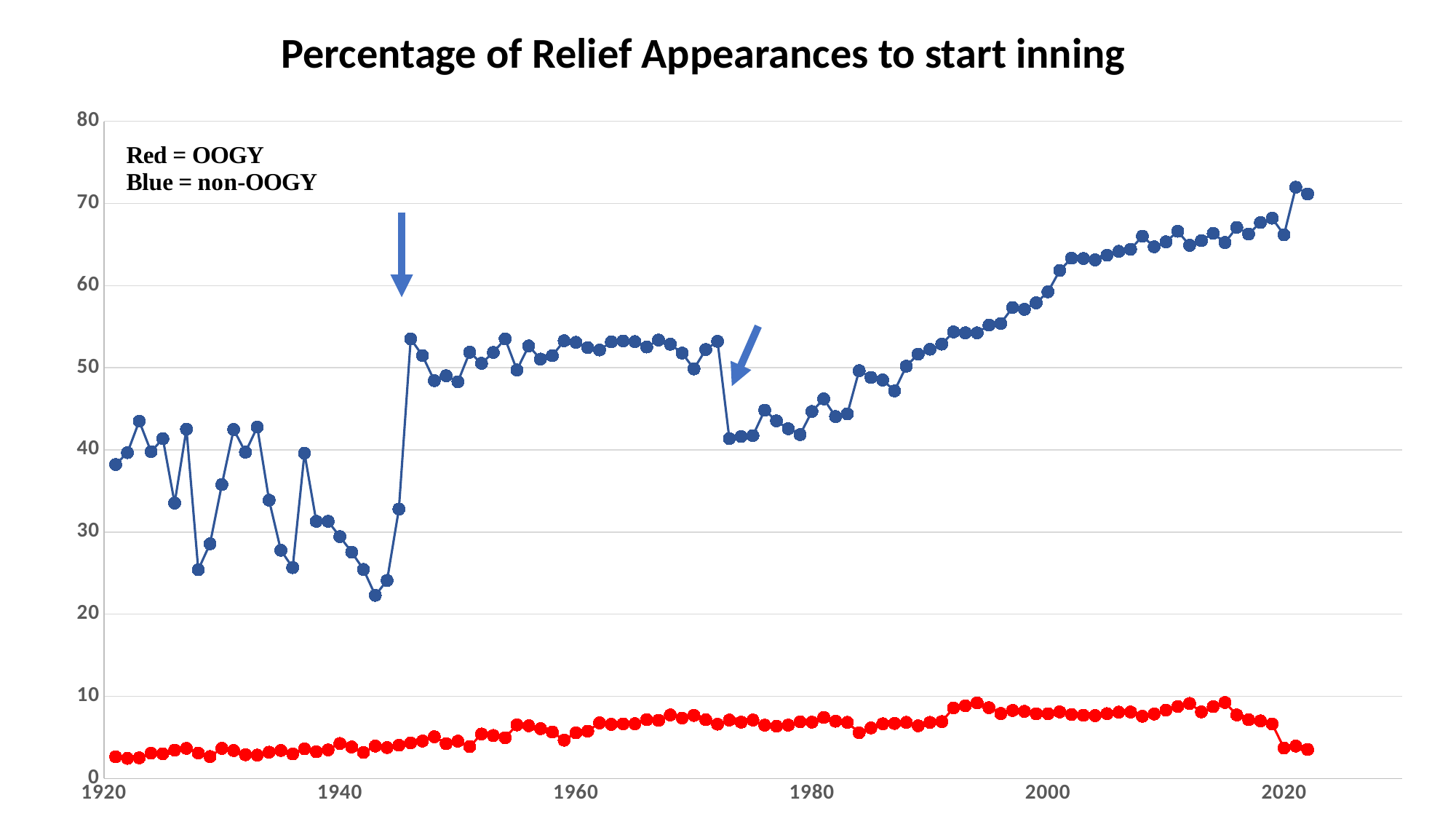
Does the red (OOGY) series rise or fall between 2015 and 2022? fall Does the blue (non-OOGY) series generally rise or fall between 1980 and 2020? rise Is the red (OOGY) value for 2000 greater or less than 10? less In 2000, which series has the larger value, red (OOGY) or blue (non-OOGY)? blue (non-OOGY) For the blue (non-OOGY) series, which is larger, the value for 1946 or the value for 1943? 1946 What is the title of the chart? Percentage of Relief Appearances to start inning How many series does the chart plot? 2 Which colour represents the OOGY series? Red Is the blue (non-OOGY) value for 1943 greater or less than 30? less What kind of chart is shown on the slide? line chart Is the blue (non-OOGY) value for 1980 greater or less than 50? less